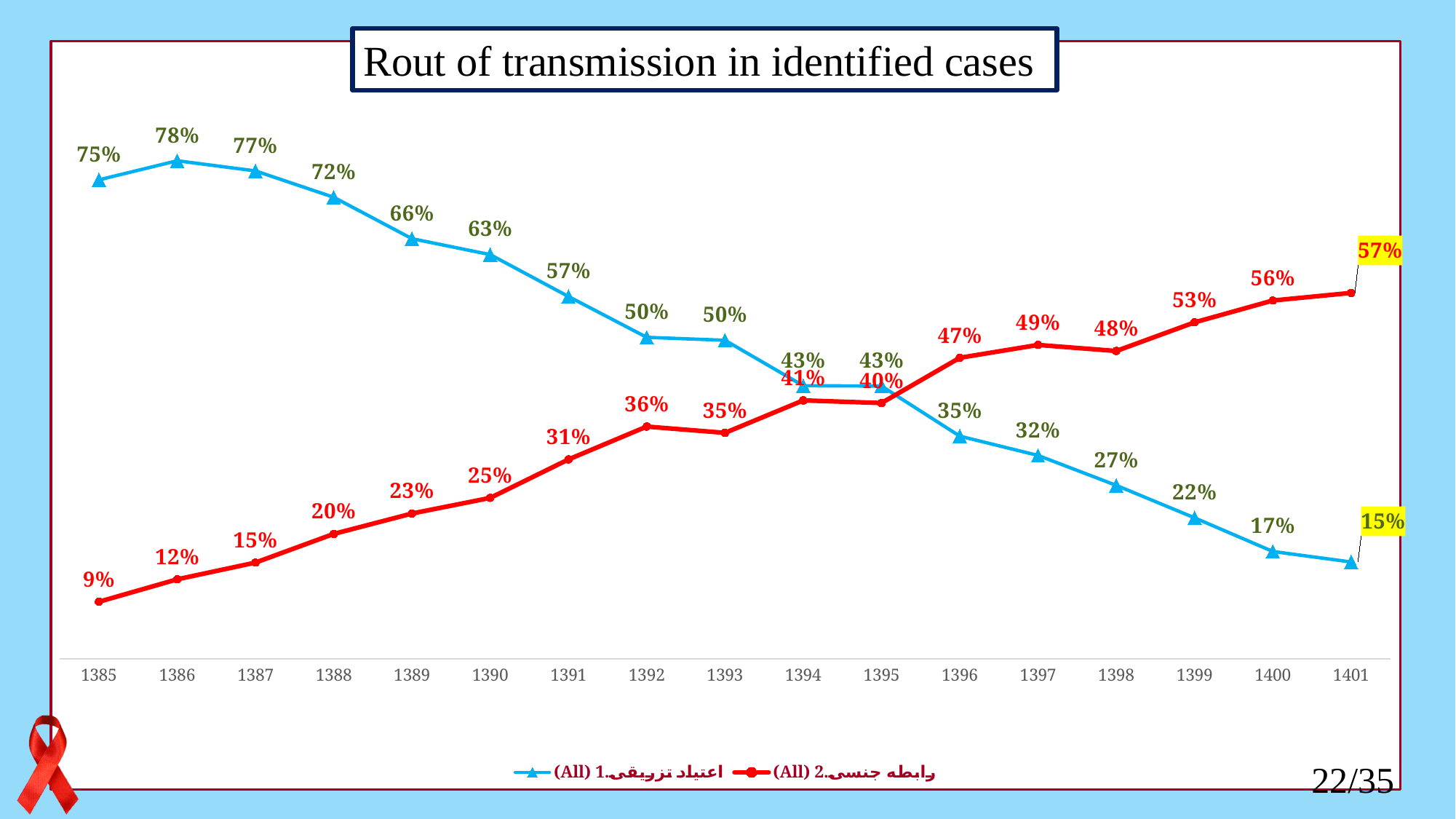
What is the title of the chart? Rout of transmission in identified cases Which line has the larger value in 1398, the blue line or the red line? the red line How many series does the legend list? 2 In which year does the blue line (اعتیاد تزریقی) reach its highest value? 1386 How many years are shown on the x axis? 17 What is the difference between the blue line and the red line in 1385? 66% Does the blue line (اعتیاد تزریقی) rise or fall from 1386 to 1401? fall What is the value of the red line (رابطه جنسی) in 1401? 57% What is the value of the red line (رابطه جنسی) in 1392? 36% What is the value of the blue line (اعتیاد تزریقی) in 1385? 75% What type of chart is shown on the slide? line chart In which year is the red line (رابطه جنسی) at its lowest value? 1385